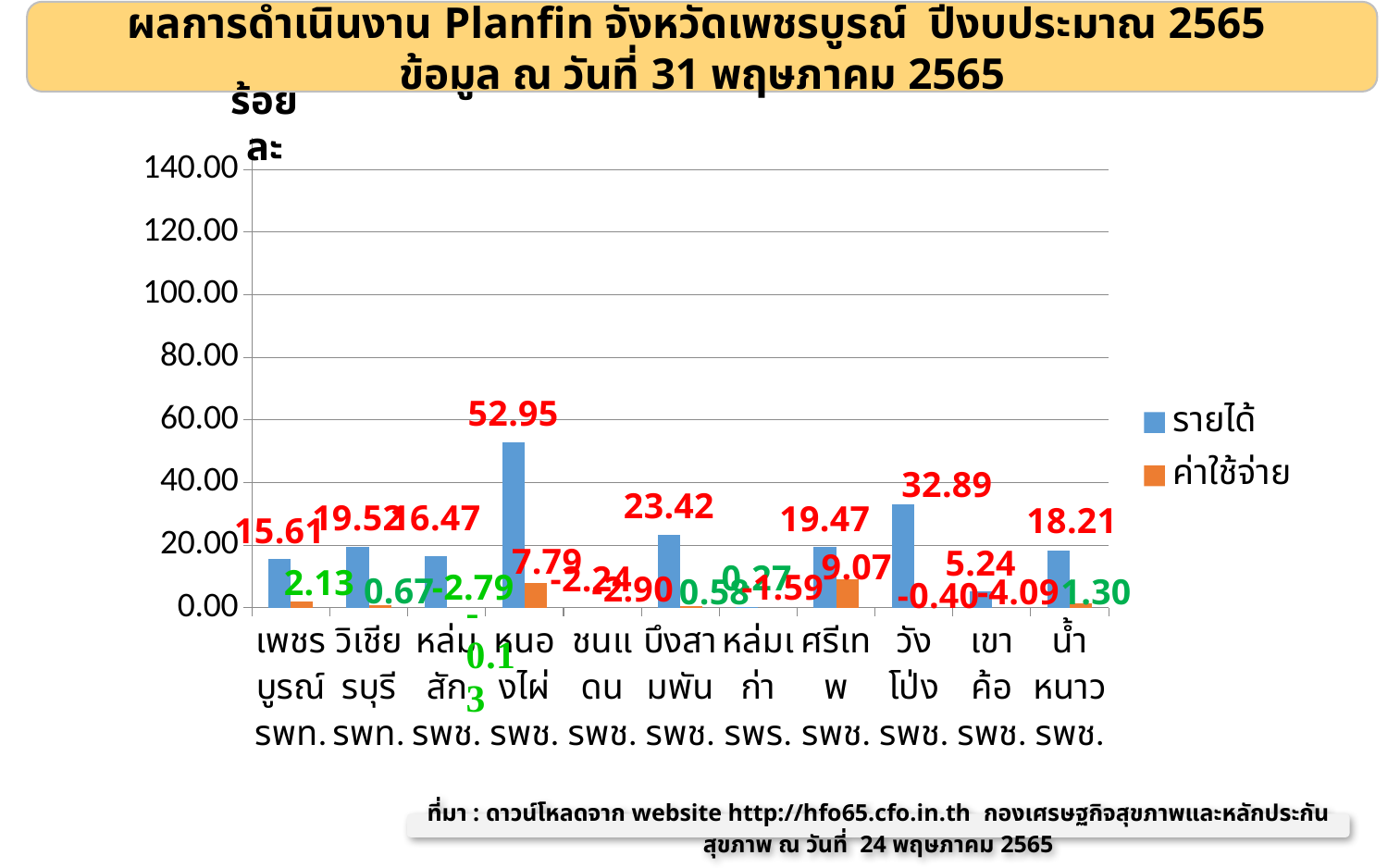
How many series does the legend list? 2 What is the ค่าใช้จ่าย value for เพชรบูรณ์ รพท.? 2.13 What are the two series named in the legend? รายได้ and ค่าใช้จ่าย What is the difference between the รายได้ values for หนองไผ่ รพช. (52.95) and วังโป่ง รพช. (32.89)? 20.06 Is the รายได้ value for หนองไผ่ รพช. greater or less than 40.00? greater Which is larger, the รายได้ value for หนองไผ่ รพช. or for วังโป่ง รพช.? หนองไผ่ รพช. What kind of chart is shown on the slide? Bar chart What is the รายได้ value for บึงสามพัน รพช.? 23.42 What is the รายได้ value for หนองไผ่ รพช.? 52.95 How many hospitals (categories) are shown on the x axis? 11 What is the รายได้ value for วังโป่ง รพช.? 32.89 Which hospital has the highest รายได้ value? หนองไผ่ รพช.